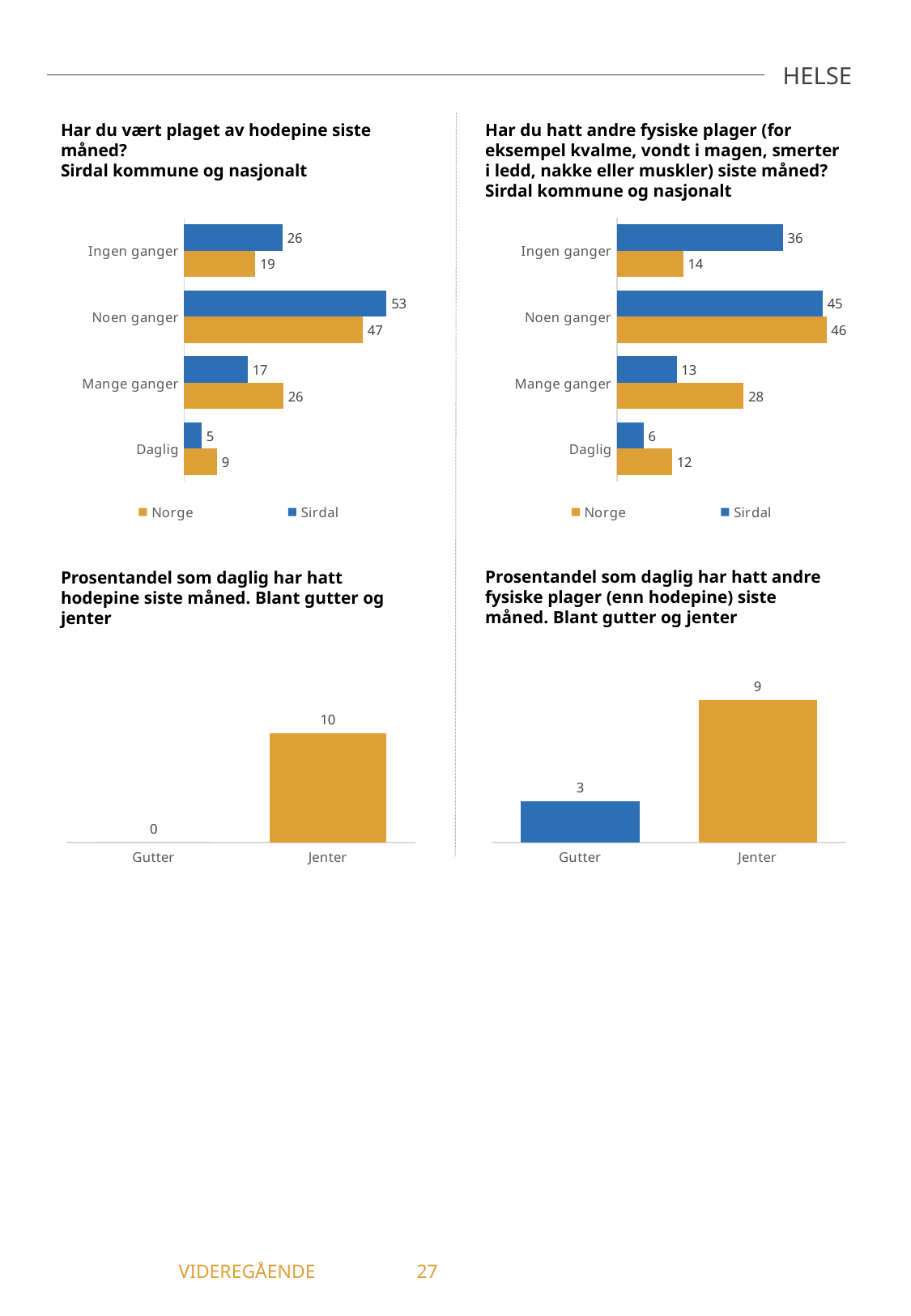
In the top-left chart (Har du vært plaget av hodepine siste måned?), how many series does the legend list? 2 In the top-left chart (Har du vært plaget av hodepine siste måned?), what is the value for Sirdal for 'Noen ganger'? 53 In the top-left chart (Har du vært plaget av hodepine siste måned?), what is the difference between the Sirdal and Norge values for 'Ingen ganger'? 7 In the top-right chart (Har du hatt andre fysiske plager siste måned?), which is larger for 'Mange ganger': Norge or Sirdal? Norge In the bottom-left chart (Prosentandel som daglig har hatt hodepine siste måned), what is the value for Jenter? 10 In the top-right chart (Har du hatt andre fysiske plager siste måned?), how many categories are shown on the axis? 4 In the bottom-left chart (Prosentandel som daglig har hatt hodepine siste måned), what is the value for Gutter? 0 What kind of chart is the bottom-right chart (Prosentandel som daglig har hatt andre fysiske plager)? Bar chart In the top-right chart (Har du hatt andre fysiske plager siste måned?), what is the value for Sirdal for 'Ingen ganger'? 36 In the top-left chart (Har du vært plaget av hodepine siste måned?), what is the value for Norge for 'Mange ganger'? 26 In the top-right chart (Har du hatt andre fysiske plager siste måned?), which category has the lowest value for Sirdal? Daglig In the bottom-right chart (Prosentandel som daglig har hatt andre fysiske plager), what is the difference between Jenter and Gutter? 6